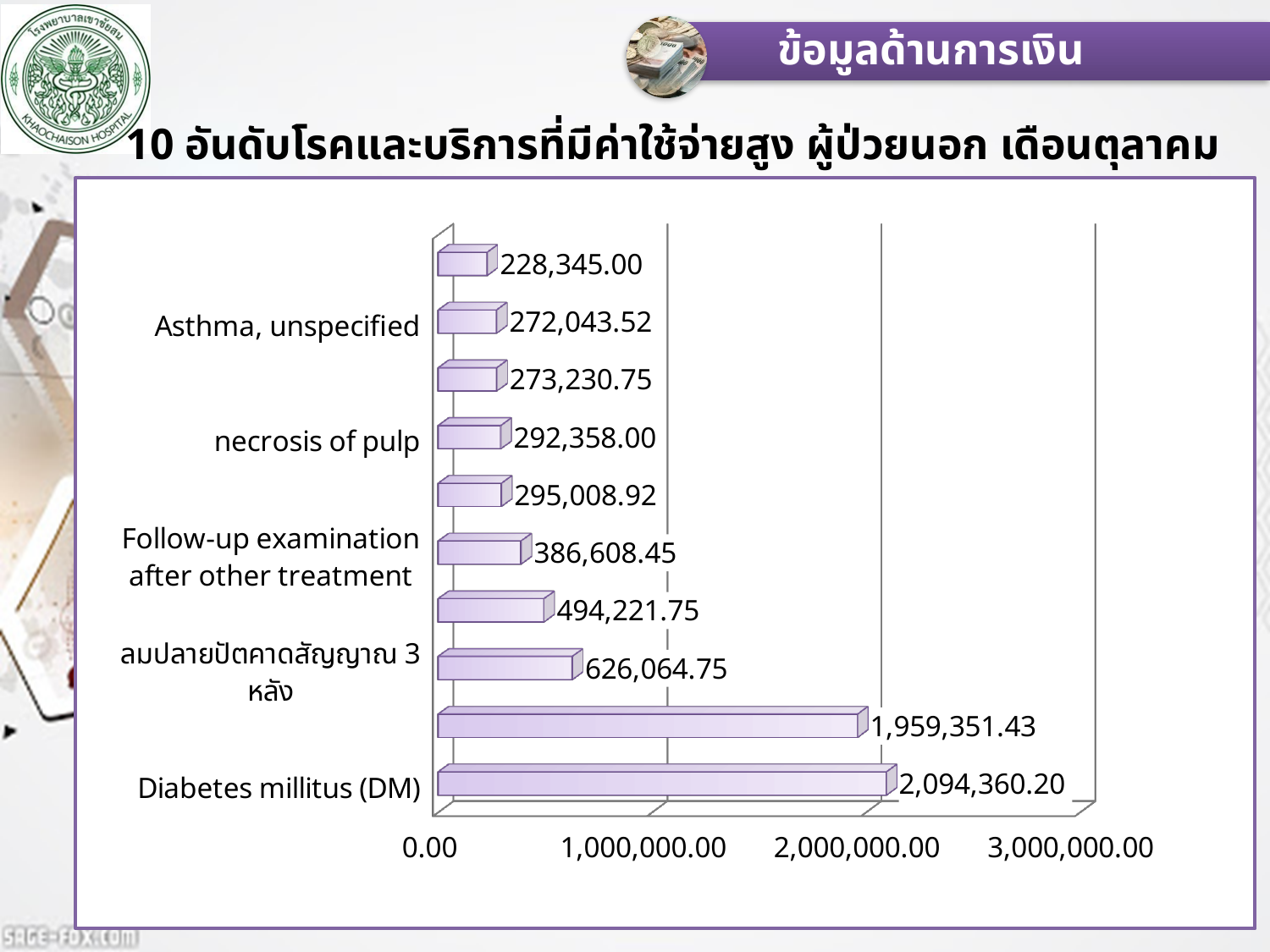
What is the value for ลมปลายปัตคาดสัญญาณ 3 หลัง? 626,064.75 Which is larger, the value for necrosis of pulp or the value for Asthma, unspecified? necrosis of pulp Is the value for Diabetes millitus (DM) greater or less than 2,000,000.00? greater What kind of chart is shown on the slide? bar chart What is the value for Follow-up examination after other treatment? 386,608.45 Which category has the highest value? Diabetes millitus (DM) What is the value for Asthma, unspecified? 272,043.52 What is the value for Diabetes millitus (DM)? 2,094,360.20 What is the value for necrosis of pulp? 292,358.00 How many bars are shown on the chart? 10 What is the smallest value shown on the chart? 228,345.00 What is the difference between the values for Diabetes millitus (DM) and Asthma, unspecified? 1,822,316.68